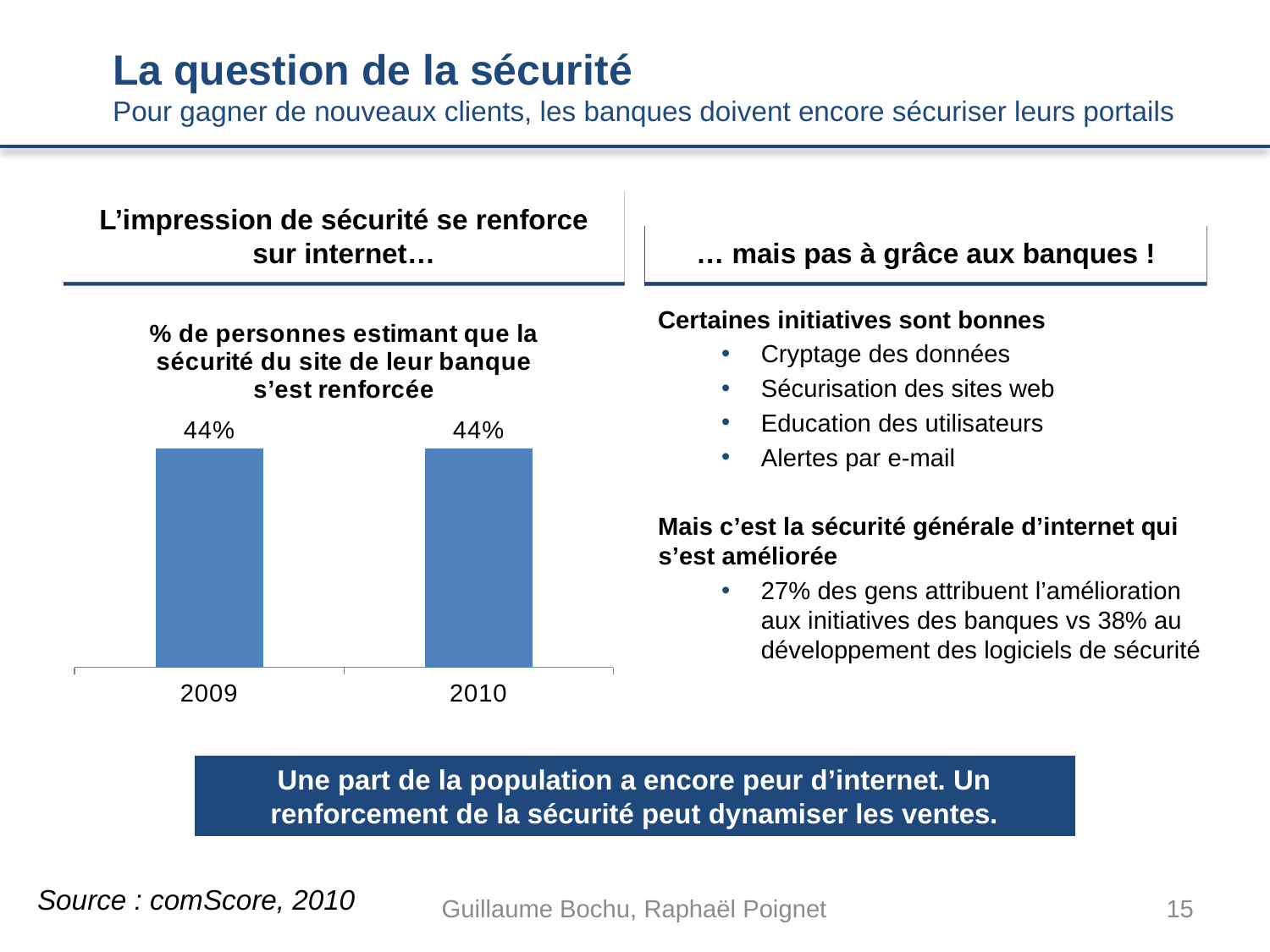
What is the difference between the values for 2009 and 2010? 0% What is the title of the chart? % de personnes estimant que la sécurité du site de leur banque s'est renforcée What kind of chart is shown on the slide? bar chart What colour are the bars in the chart? blue Which years are shown as categories in the chart? 2009 and 2010 How many categories are shown on the x axis of the chart? 2 What is the value for 2009? 44% Do the values rise, fall or stay the same from 2009 to 2010? stay the same What is the value for 2010? 44%